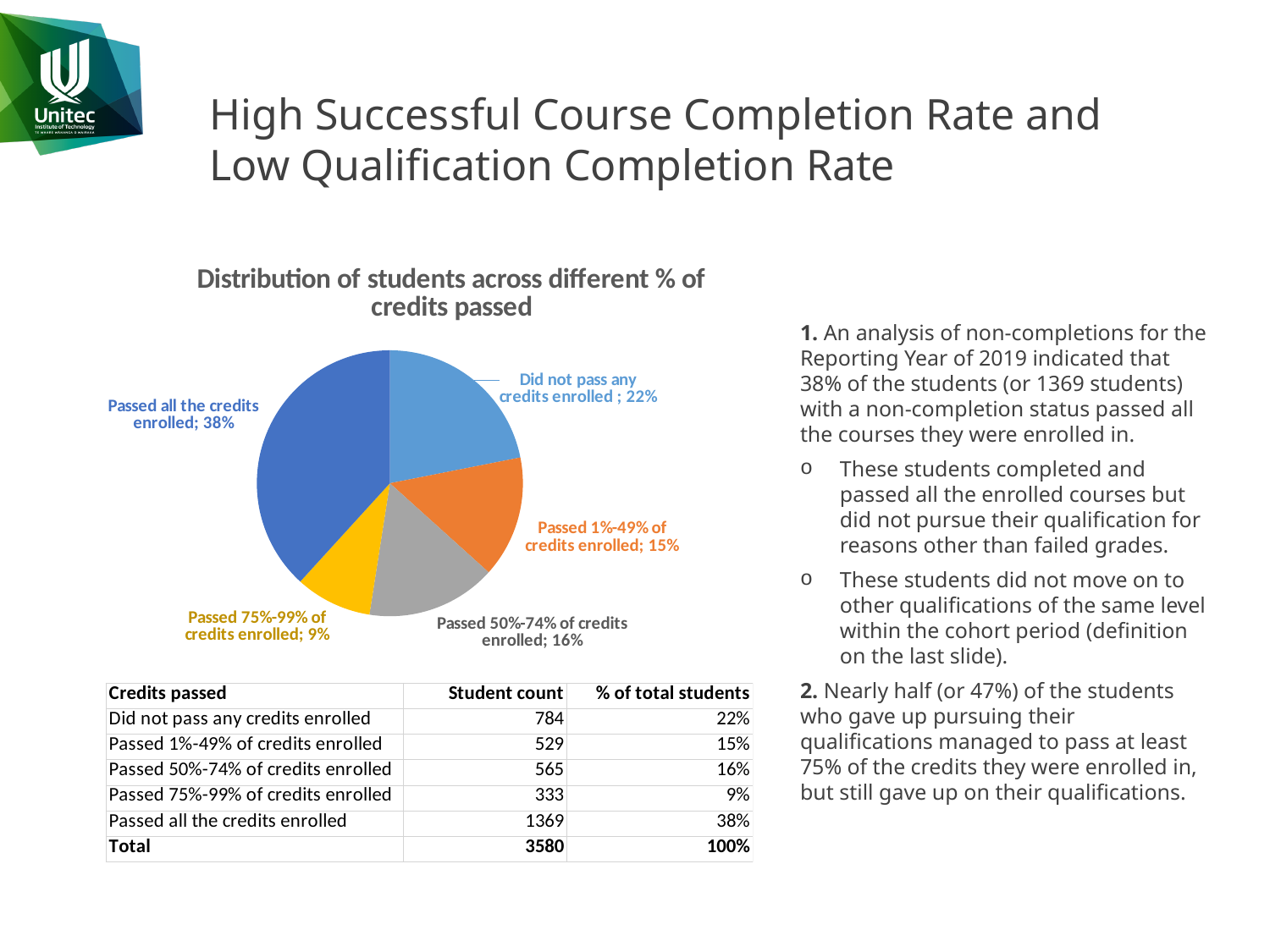
What is the difference in percentage points between 'Passed all the credits enrolled' and 'Did not pass any credits enrolled'? 16 percentage points How many slices does the pie chart have? 5 Which is larger: the share for 'Passed 50%-74% of credits enrolled' or 'Passed 1%-49% of credits enrolled'? Passed 50%-74% of credits enrolled What is the title of the chart? Distribution of students across different % of credits passed What share of students passed all the credits enrolled? 38% What type of chart is shown on the slide? pie chart What share of students did not pass any credits enrolled? 22% What is the combined share of 'Passed 75%-99% of credits enrolled' and 'Passed all the credits enrolled'? 47% What share of students passed 75%-99% of credits enrolled? 9% Which category has the largest slice of the pie? Passed all the credits enrolled What colour is the slice for 'Passed 1%-49% of credits enrolled'? orange Which category has the smallest slice of the pie? Passed 75%-99% of credits enrolled